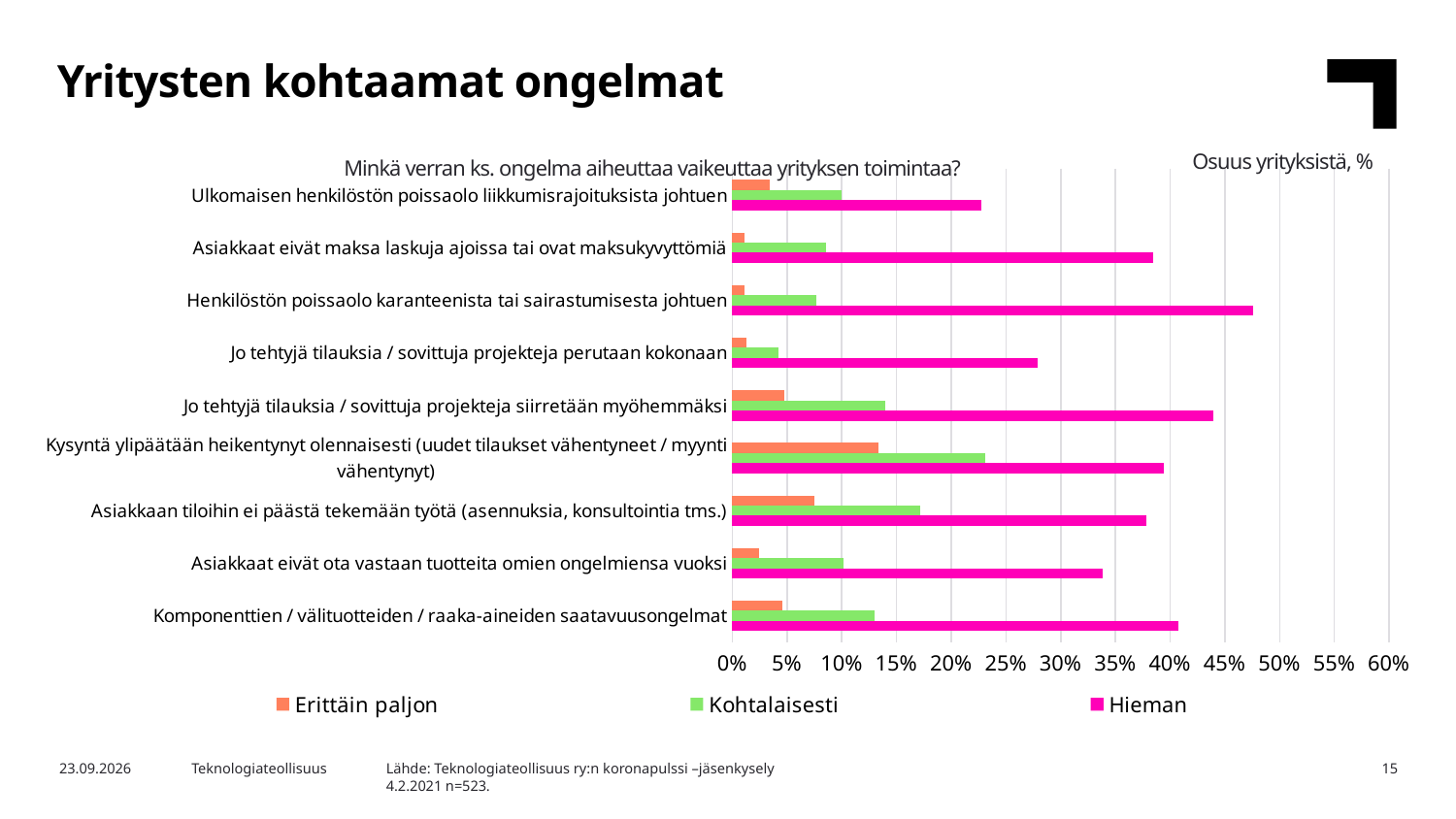
Is the 'Hieman' value for 'Henkilöstön poissaolo karanteenista tai sairastumisesta johtuen' greater or less than 45%? greater How many series does the legend list? 3 Which is larger: the 'Hieman' value for 'Jo tehtyjä tilauksia / sovittuja projekteja siirretään myöhemmäksi' or for 'Jo tehtyjä tilauksia / sovittuja projekteja perutaan kokonaan'? Jo tehtyjä tilauksia / sovittuja projekteja siirretään myöhemmäksi Is the 'Hieman' value for 'Ulkomaisen henkilöstön poissaolo liikkumisrajoituksista johtuen' greater or less than 25%? less Which category has the lowest value for the 'Hieman' series? Ulkomaisen henkilöstön poissaolo liikkumisrajoituksista johtuen Which category has the lowest value for the 'Kohtalaisesti' series? Jo tehtyjä tilauksia / sovittuja projekteja perutaan kokonaan Which colour represents the 'Hieman' series in the chart? magenta (pink) Which category has the highest value for the 'Hieman' series? Henkilöstön poissaolo karanteenista tai sairastumisesta johtuen Which category has the highest value for the 'Erittäin paljon' series? Kysyntä ylipäätään heikentynyt olennaisesti (uudet tilaukset vähentyneet / myynti vähentynyt) Is the 'Kohtalaisesti' value for 'Kysyntä ylipäätään heikentynyt olennaisesti' greater or less than 20%? greater How many problem categories are plotted on the chart? 9 What kind of chart is shown on the slide? bar chart